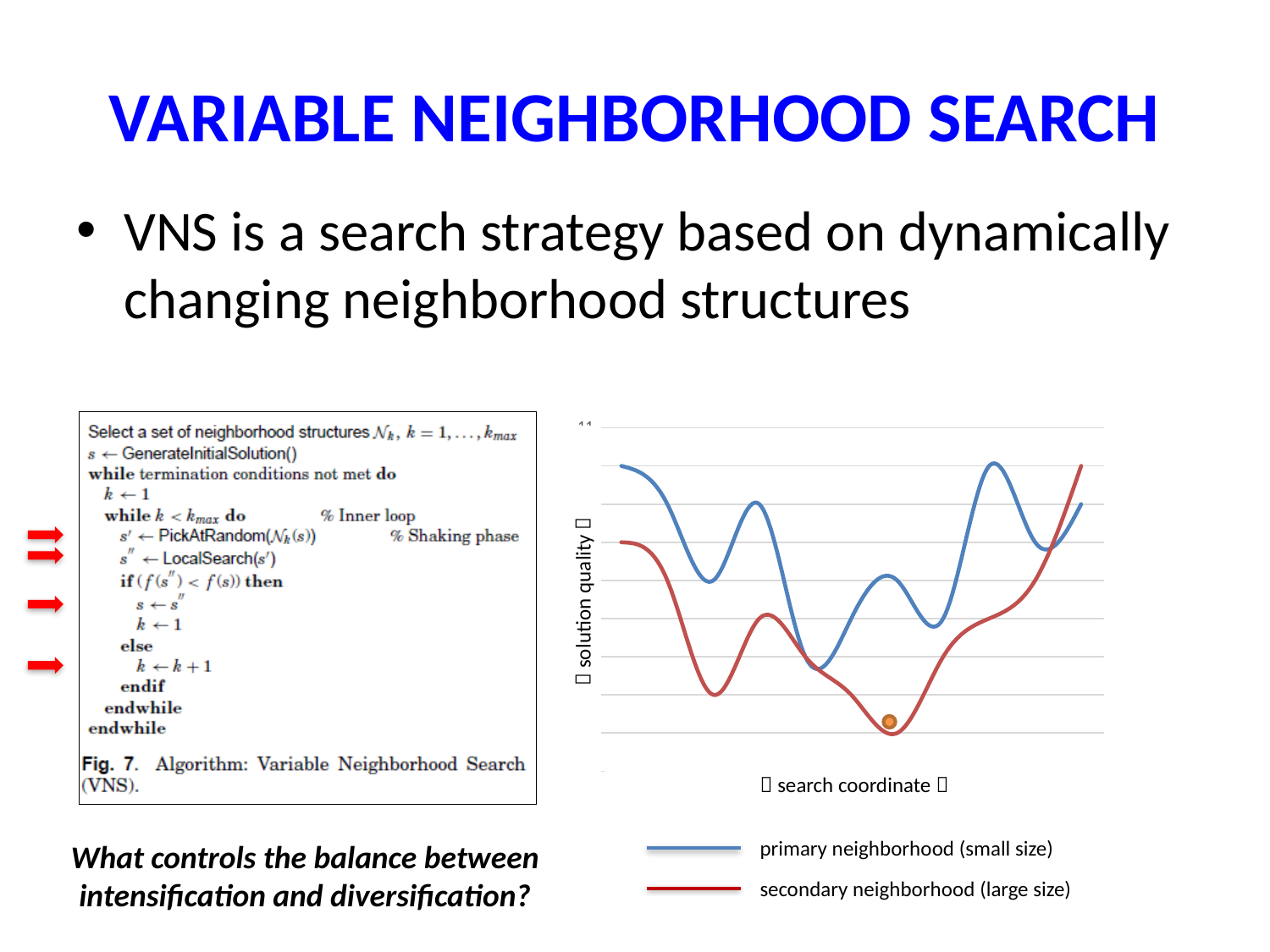
What is the label on the vertical axis of the chart? solution quality What kind of chart is shown on the right of the slide? line chart Which series reaches the lowest point on the chart, the primary neighborhood (small size) or the secondary neighborhood (large size)? secondary neighborhood (large size) At the left edge of the chart, which curve starts higher, the primary neighborhood (small size) or the secondary neighborhood (large size)? primary neighborhood (small size) What colour is the line for the primary neighborhood (small size) in the chart? blue How many series does the legend of the chart list? 2